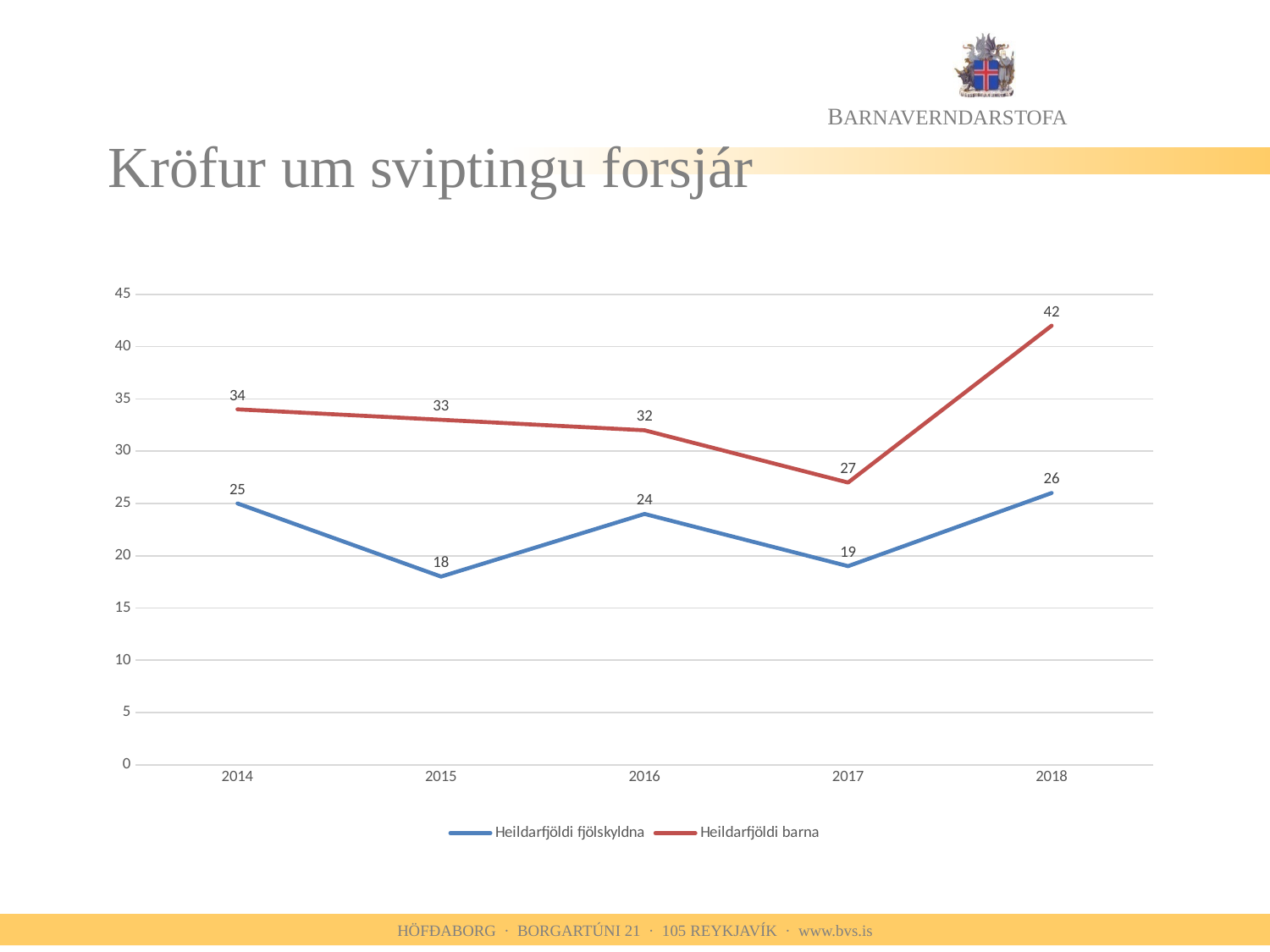
What is the difference between Heildarfjöldi barna and Heildarfjöldi fjölskyldna in 2014? 9 What type of chart is shown on the slide? line chart What is the value for Heildarfjöldi fjölskyldna in 2015? 18 How many years are shown on the x axis? 5 In which year is Heildarfjöldi barna highest? 2018 How many series does the legend list? 2 In which year is Heildarfjöldi fjölskyldna lowest? 2015 Does Heildarfjöldi barna rise or fall from 2014 to 2017? fall What is the value for Heildarfjöldi barna in 2018? 42 What is the value for Heildarfjöldi fjölskyldna in 2017? 19 What is the title of the chart? Kröfur um sviptingu forsjár Which is larger in 2016: Heildarfjöldi fjölskyldna or Heildarfjöldi barna? Heildarfjöldi barna